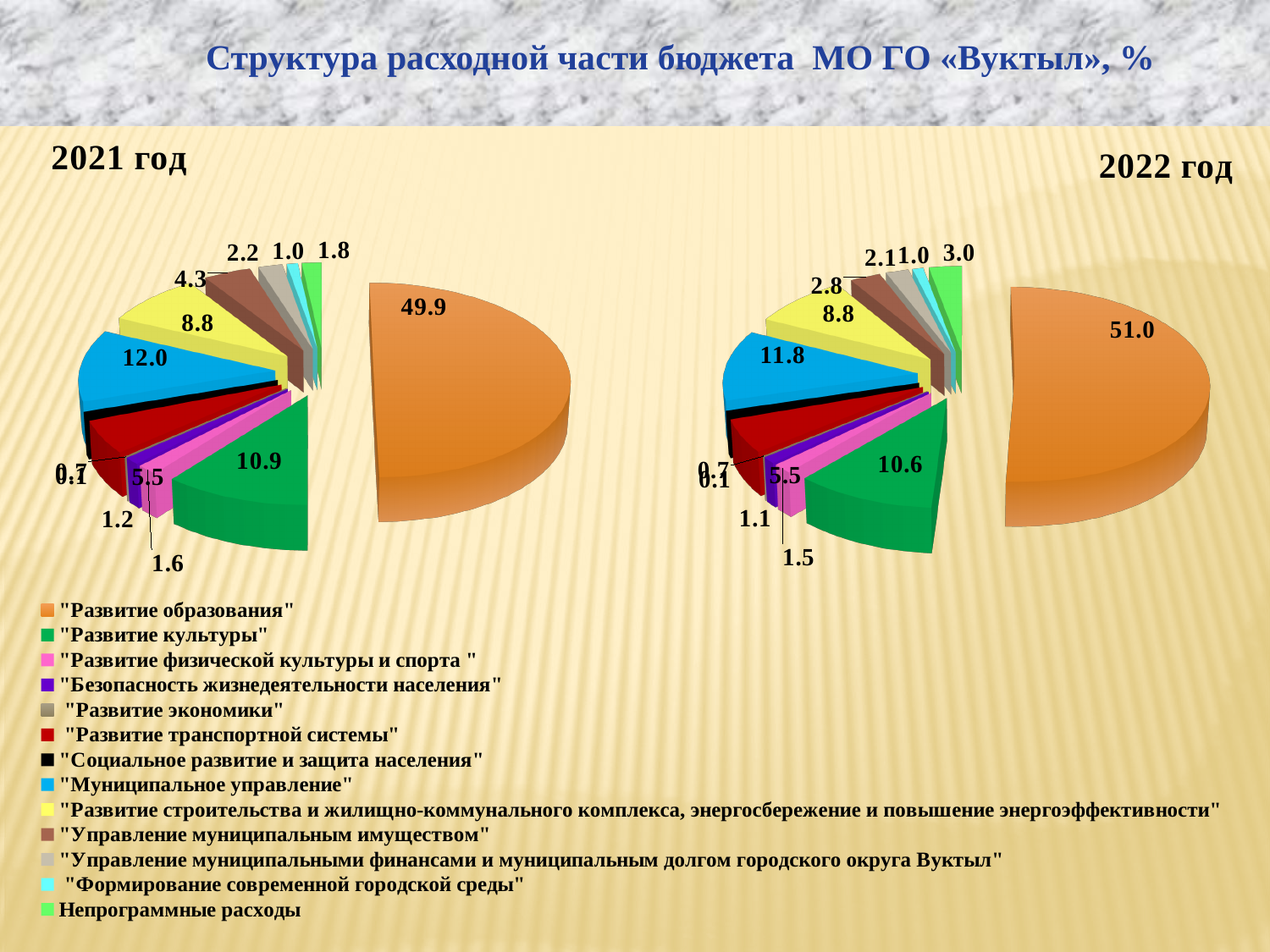
In the 2022 год pie chart, what share is shown for "Развитие образования"? 51.0 In the 2021 год pie chart, what is the difference between the values for "Муниципальное управление" and "Развитие строительства и жилищно-коммунального комплекса, энергосбережение и повышение энергоэффективности"? 3.2 How many categories does the legend list? 13 Is the share of "Развитие культуры" larger in the 2021 год chart or the 2022 год chart? 2021 год In the 2021 год pie chart, which category has the largest slice? "Развитие образования" By how much does the share of "Развитие образования" in the 2022 год chart exceed its share in the 2021 год chart? 1.1 In the 2022 год pie chart, what value is shown for "Непрограммные расходы"? 3.0 What type of chart is used on this slide for 2021 год and 2022 год? Pie chart In the 2021 год pie chart, what share is shown for "Развитие образования"? 49.9 What is the title of the slide containing the two pie charts? Структура расходной части бюджета МО ГО «Вуктыл», % In the 2022 год pie chart, what value is shown for "Муниципальное управление"? 11.8 In the 2021 год pie chart, what value is shown for "Управление муниципальным имуществом"? 4.3